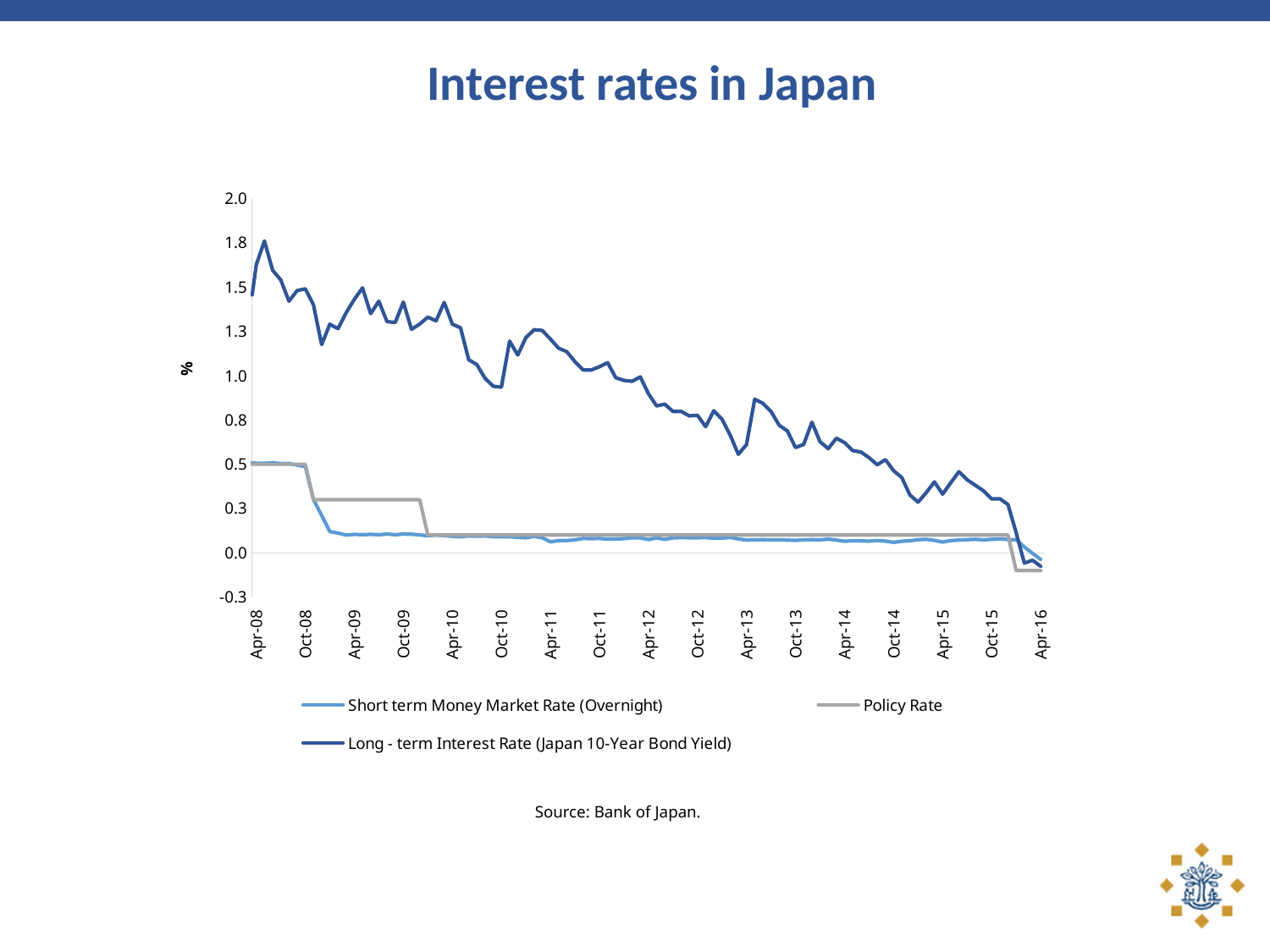
Is the Long - term Interest Rate (Japan 10-Year Bond Yield) at Apr-13 greater or less than 1.0? less Is the Policy Rate at Apr-09 greater or less than 0.5? less How many series does the legend list? 3 Is the Long - term Interest Rate (Japan 10-Year Bond Yield) at Apr-16 greater or less than 0.5? less Which is larger at Apr-12: the Long - term Interest Rate (Japan 10-Year Bond Yield) or the Policy Rate? Long - term Interest Rate (Japan 10-Year Bond Yield) What is the label on the vertical axis? % Does the Long - term Interest Rate (Japan 10-Year Bond Yield) generally rise or fall from Apr-08 to Apr-16? Fall What is the title of the chart? Interest rates in Japan How many date labels are shown on the horizontal axis? 17 What kind of chart is shown on the slide? Line chart